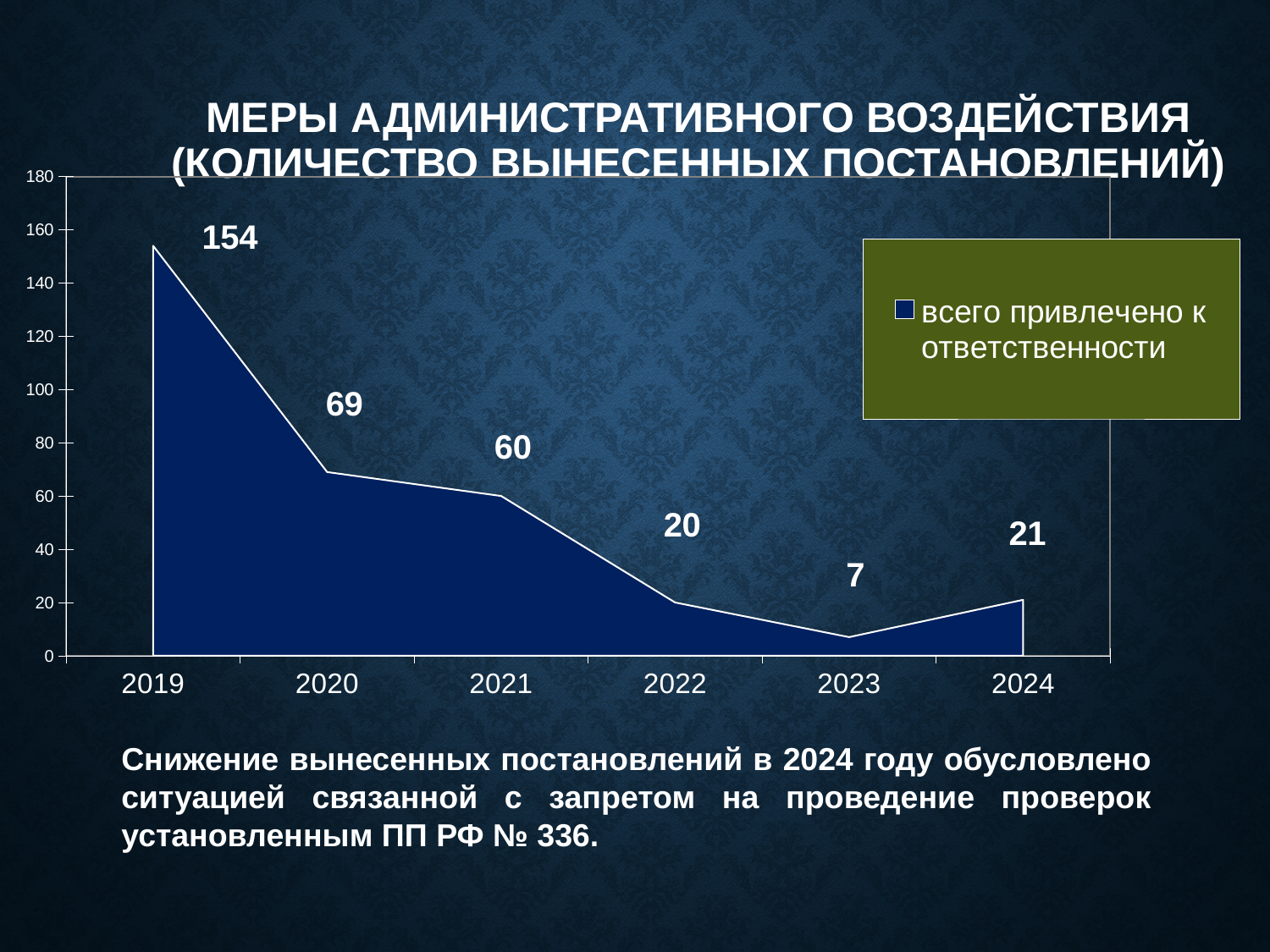
What kind of chart is shown? area chart Which is larger, the value for 2020 or the value for 2021? 2020 Which year has the lowest value? 2023 How many years are plotted on the x axis? 6 Do the values generally rise or fall from 2019 to 2023? fall What is the difference between the values for 2024 and 2023? 14 Which year has the highest value? 2019 What is the value for 2022? 20 What is the difference between the values for 2019 and 2020? 85 What is the value for 2019? 154 How many series does the legend list? 1 What is the value for 2024? 21